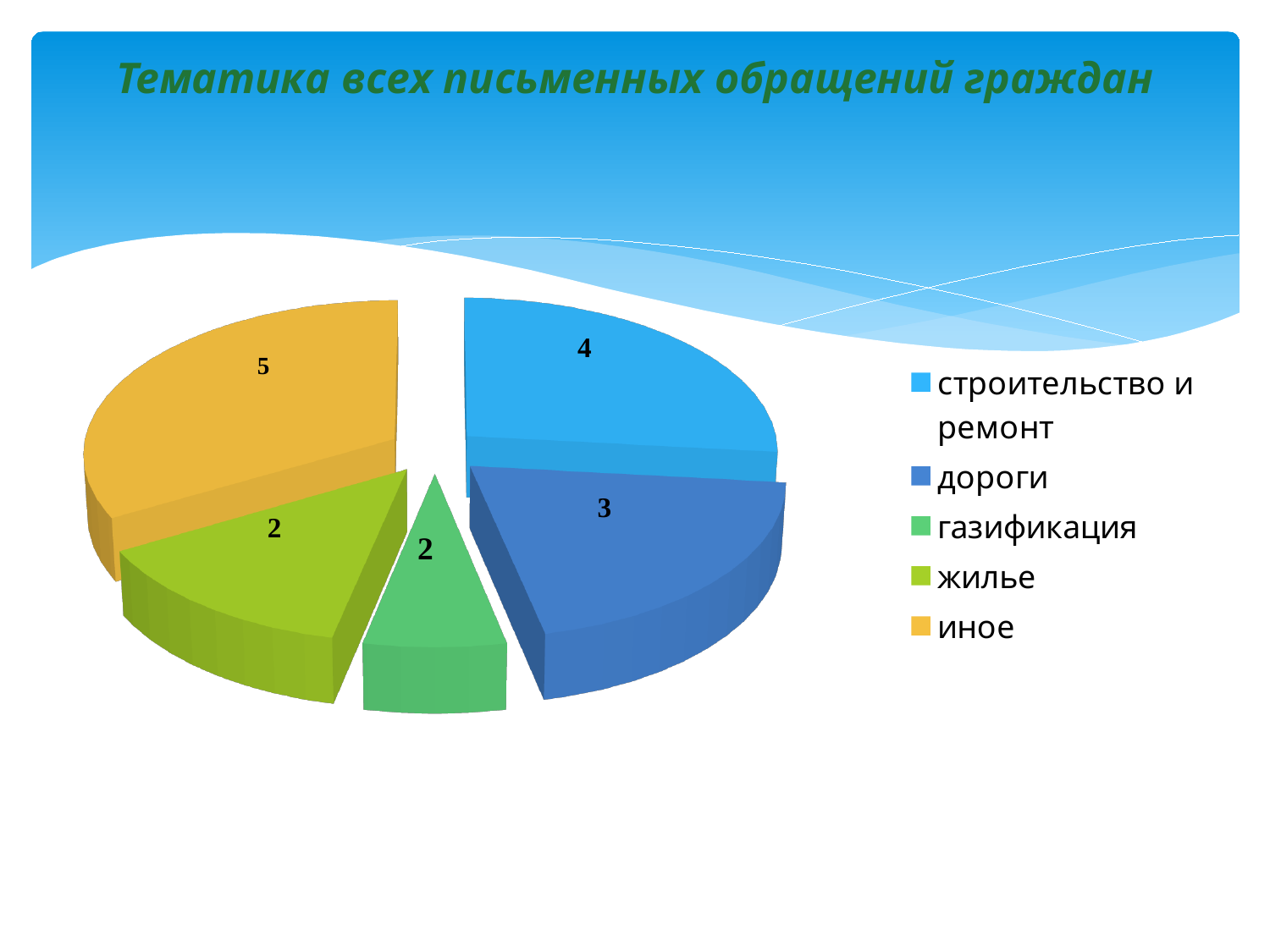
How many categories does the pie chart have? 5 What is the value for строительство и ремонт? 4 What kind of chart is shown on the slide? Pie chart What is the value for жилье? 2 What is the title of the slide? Тематика всех письменных обращений граждан Which is larger, the value for строительство и ремонт or the value for дороги? строительство и ремонт What colour is the slice for иное? Yellow What is the value for иное? 5 Which category has the largest slice? иное What is the difference between the values for иное and дороги? 2 What is the value for дороги? 3